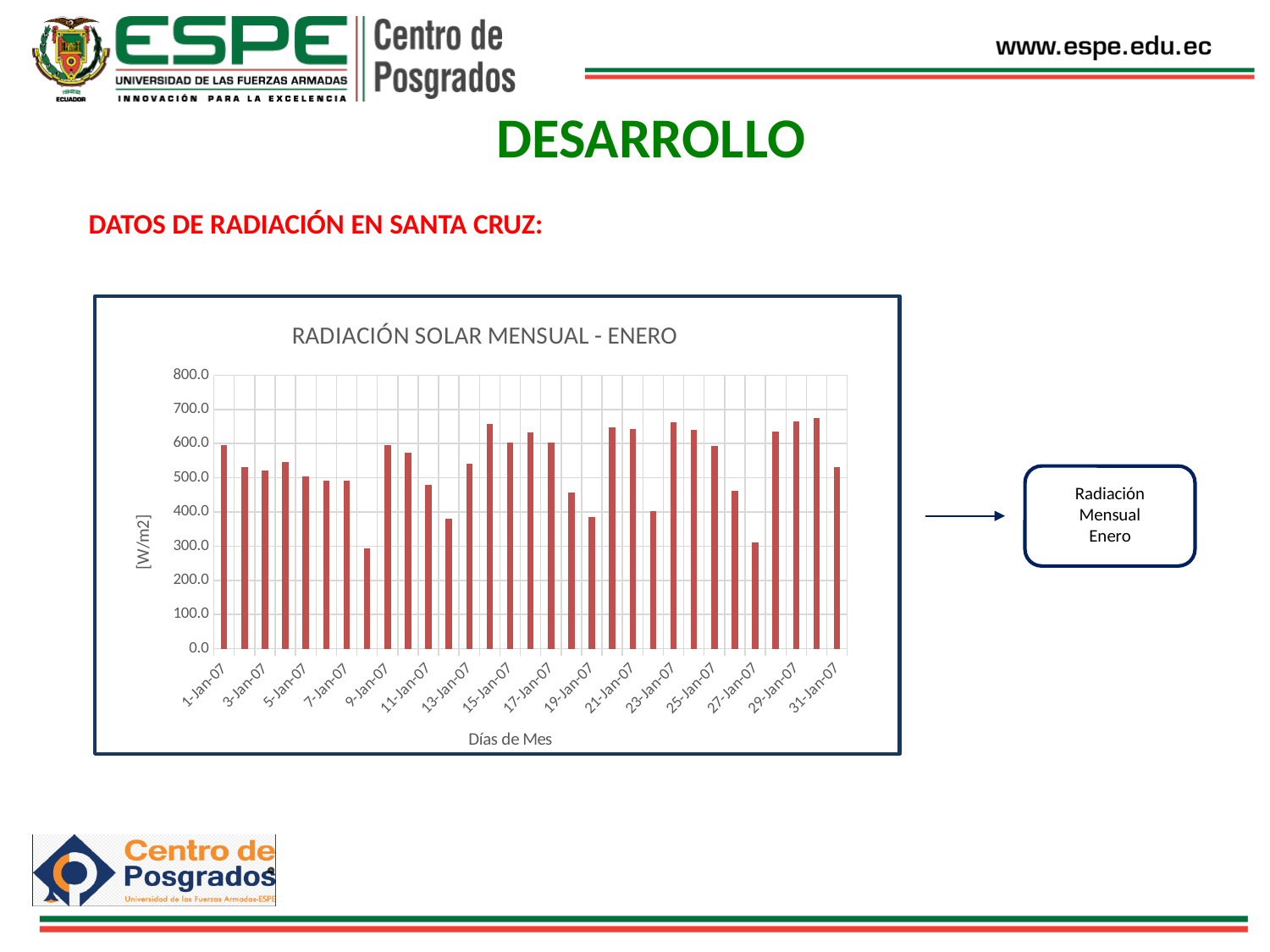
Is the value for 8-Jan-07 greater or less than 400? less Which day has the higher value, 27-Jan-07 or 29-Jan-07? 29-Jan-07 Which day has the higher value, 1-Jan-07 or 8-Jan-07? 1-Jan-07 How many bars (days) are plotted in the chart? 31 What is the title of the chart? RADIACIÓN SOLAR MENSUAL - ENERO What kind of chart is shown on the slide? Bar chart Which day has the higher value, 12-Jan-07 or 14-Jan-07? 14-Jan-07 Is the value for 27-Jan-07 greater or less than 400? less What is the label of the vertical axis of the chart? [W/m2] Is the value for 1-Jan-07 greater or less than 500? greater